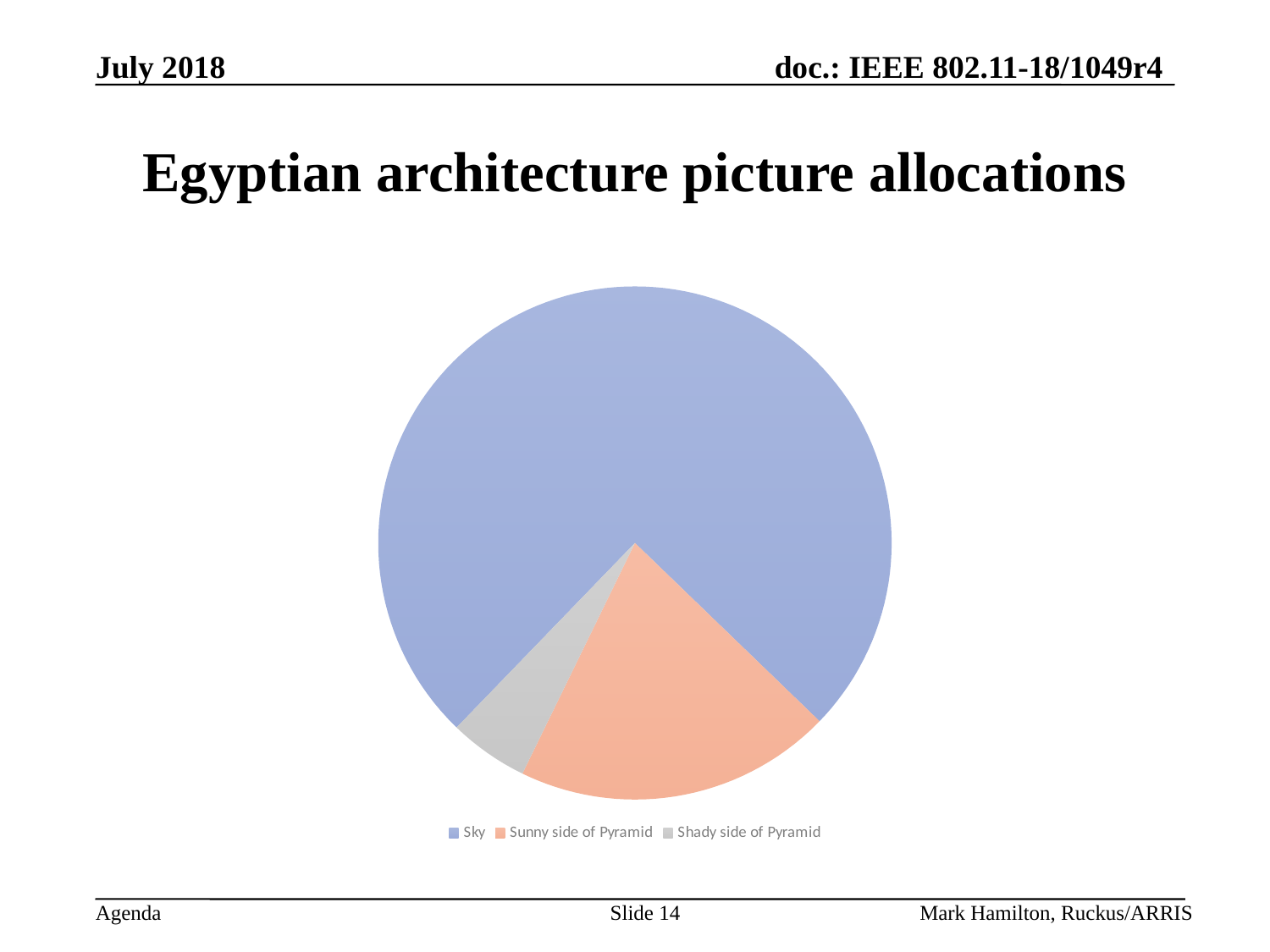
Which is larger in the pie chart, Sunny side of Pyramid or Shady side of Pyramid? Sunny side of Pyramid What are the three legend entries of the pie chart? Sky, Sunny side of Pyramid, Shady side of Pyramid Which slice of the pie chart is the largest? Sky What kind of chart is shown on the slide? pie chart What colour is the Sky slice in the pie chart? blue How many slices does the pie chart have? 3 How many entries does the legend of the pie chart list? 3 Does the Sky slice take up more or less than half of the pie chart? more Which is larger in the pie chart, Sky or Sunny side of Pyramid? Sky Which slice of the pie chart is the smallest? Shady side of Pyramid